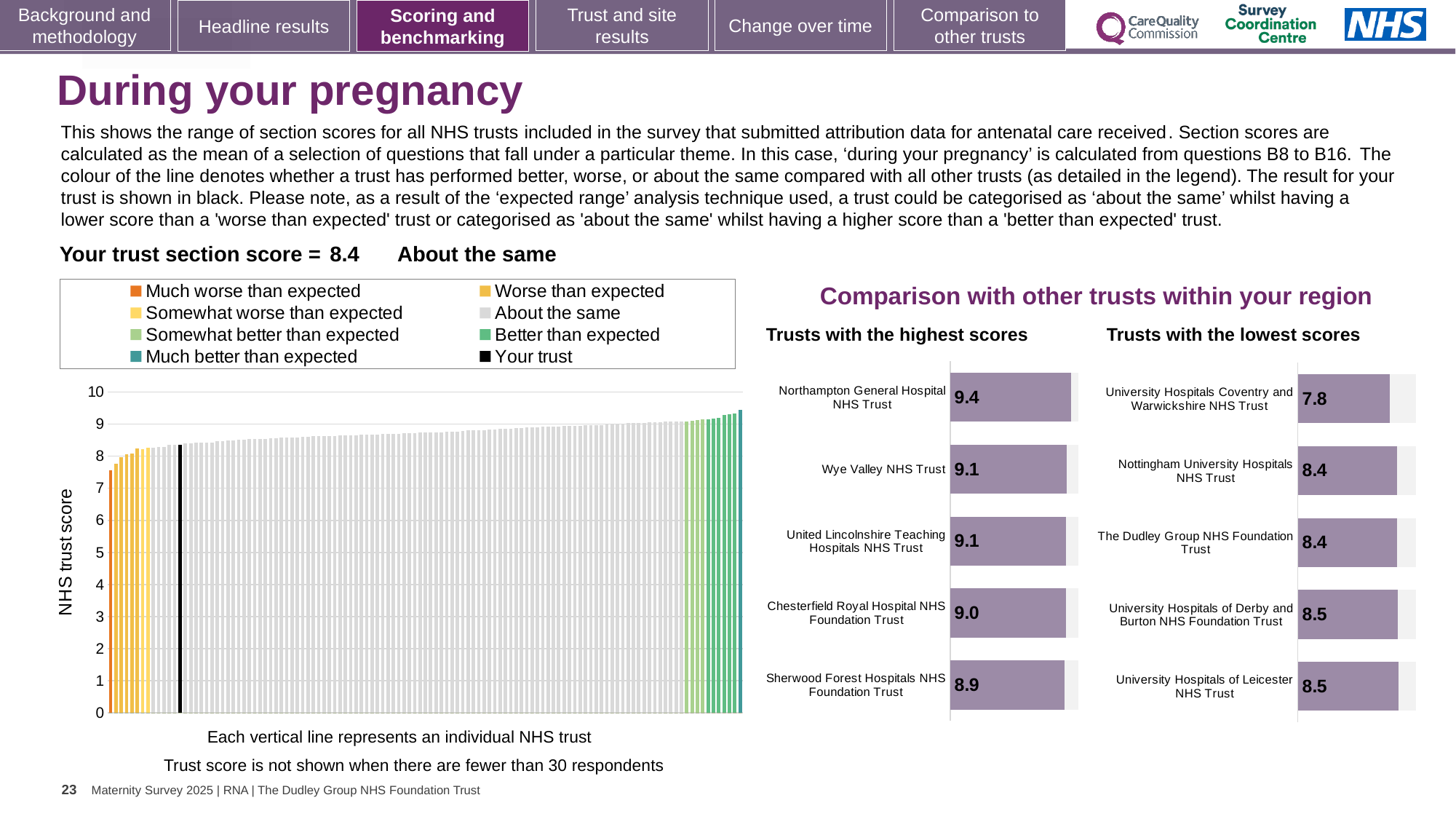
In the 'Trusts with the lowest scores' chart, what is the difference between the scores of University Hospitals of Leicester NHS Trust and University Hospitals Coventry and Warwickshire NHS Trust? 0.7 In the 'Trusts with the highest scores' chart, what is the score for Northampton General Hospital NHS Trust? 9.4 In the 'Trusts with the lowest scores' chart, what is the score for The Dudley Group NHS Foundation Trust? 8.4 How many trusts are shown in the 'Trusts with the highest scores' chart? 5 In the 'Trusts with the lowest scores' chart, what is the score for University Hospitals Coventry and Warwickshire NHS Trust? 7.8 In the NHS trust score chart on the left, do the trust scores rise or fall from left to right along the x axis? rise In the 'Trusts with the lowest scores' chart, which trust has the lowest score? University Hospitals Coventry and Warwickshire NHS Trust In the 'Trusts with the highest scores' chart, which trust has the highest score? Northampton General Hospital NHS Trust How many entries does the legend of the NHS trust score chart on the left list? 8 In the 'Trusts with the highest scores' chart, what is the difference between the scores of Northampton General Hospital NHS Trust and Sherwood Forest Hospitals NHS Foundation Trust? 0.5 In the 'Trusts with the highest scores' chart, which has the higher score: Wye Valley NHS Trust or Chesterfield Royal Hospital NHS Foundation Trust? Wye Valley NHS Trust In the NHS trust score chart on the left, is the value for the lowest (orange) trust greater or less than 8? less